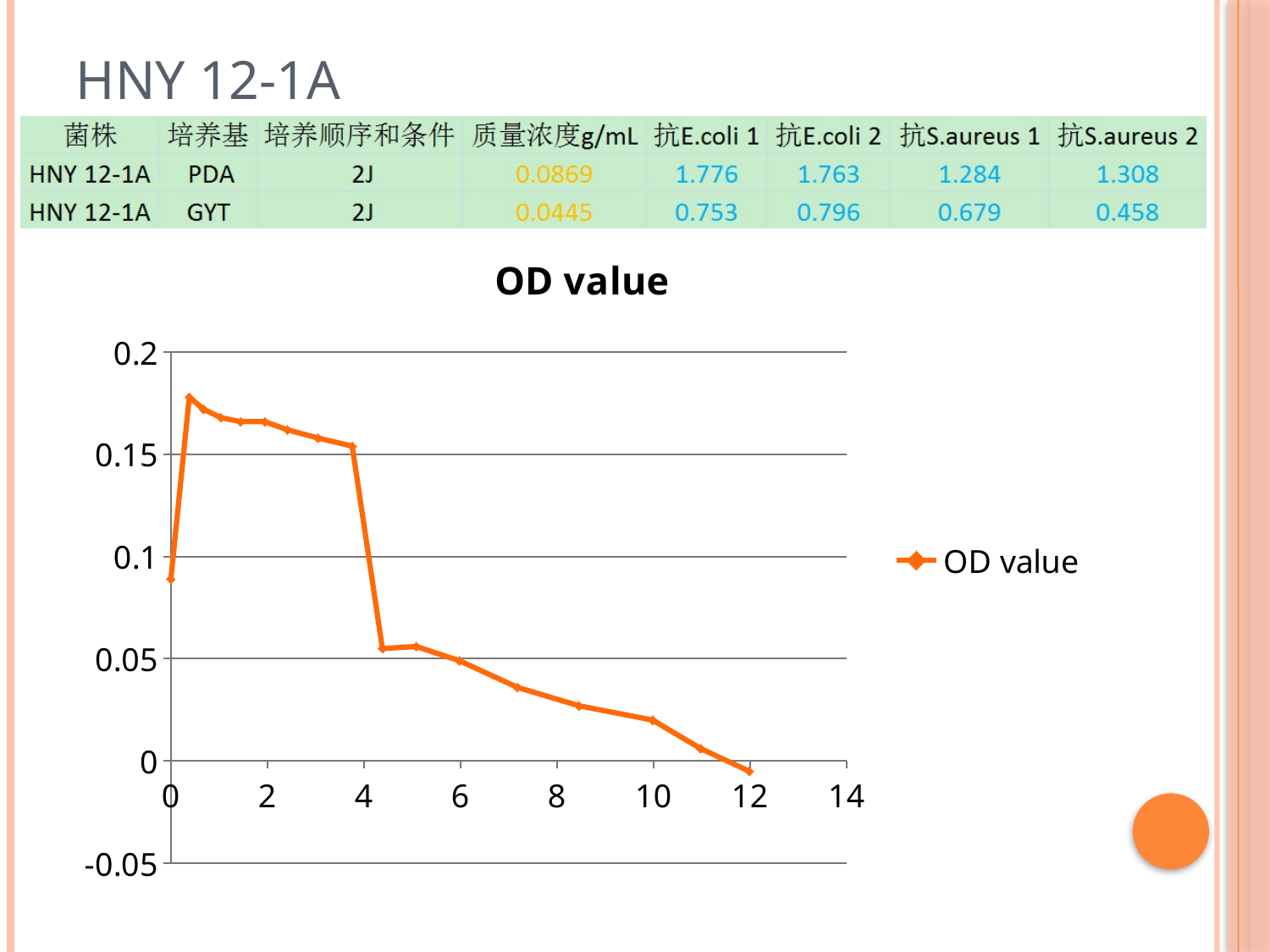
Is the OD value at x = 0 greater or less than 0.1? less Is the OD value at x = 6 greater or less than 0.1? less Is the OD value at x = 10 greater or less than 0.05? less Overall, do the OD values rise or fall as the x axis increases from 2 to 12? fall How many series does the chart legend list? 1 Which is larger, the OD value at x = 2 or the OD value at x = 6? x = 2 What kind of chart is shown on the slide? line chart What is the title of the chart? OD value What is the name of the series shown in the legend? OD value